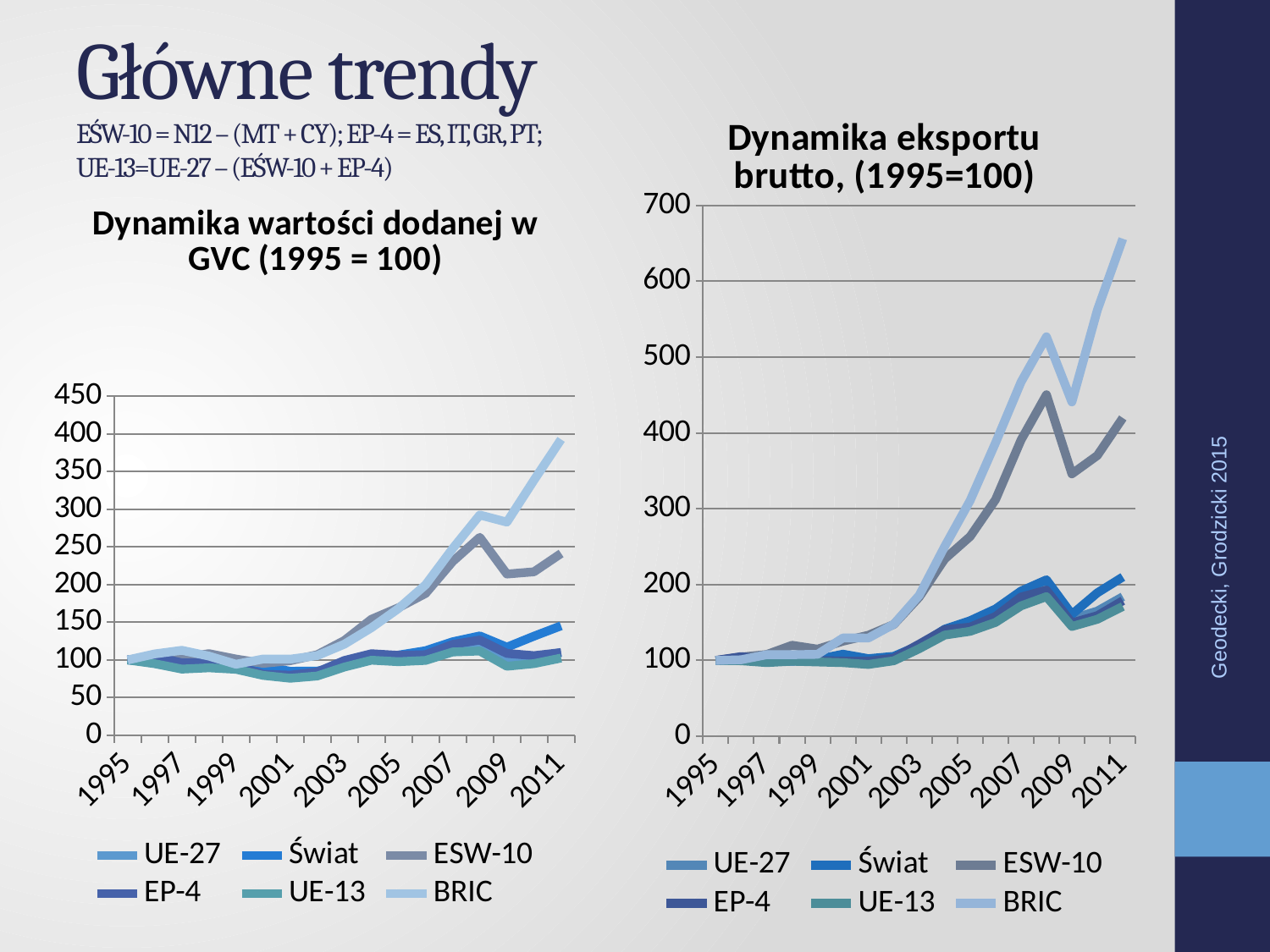
In the 'Dynamika wartości dodanej w GVC (1995 = 100)' chart, which series has the highest value in 2011? BRIC In the 'Dynamika eksportu brutto, (1995=100)' chart, which series has the highest value in 2011? BRIC What value do all series start at in 1995 in the 'Dynamika wartości dodanej w GVC (1995 = 100)' chart? 100 In the 'Dynamika eksportu brutto, (1995=100)' chart, is the value for ESW-10 in 2011 greater or less than 300? greater In the 'Dynamika eksportu brutto, (1995=100)' chart, is the value for BRIC in 2011 greater or less than 600? greater In the 'Dynamika wartości dodanej w GVC (1995 = 100)' chart, is the value for UE-13 in 2011 greater or less than 150? less How many series does the legend of the 'Dynamika wartości dodanej w GVC (1995 = 100)' chart list? 6 What kind of chart is the 'Dynamika eksportu brutto, (1995=100)' chart? line chart In the 'Dynamika eksportu brutto, (1995=100)' chart, which is larger in 2011: BRIC or ESW-10? BRIC In the 'Dynamika eksportu brutto, (1995=100)' chart, does the BRIC series overall rise or fall from 1995 to 2011? rise What is the highest value shown on the vertical axis of the 'Dynamika eksportu brutto, (1995=100)' chart? 700